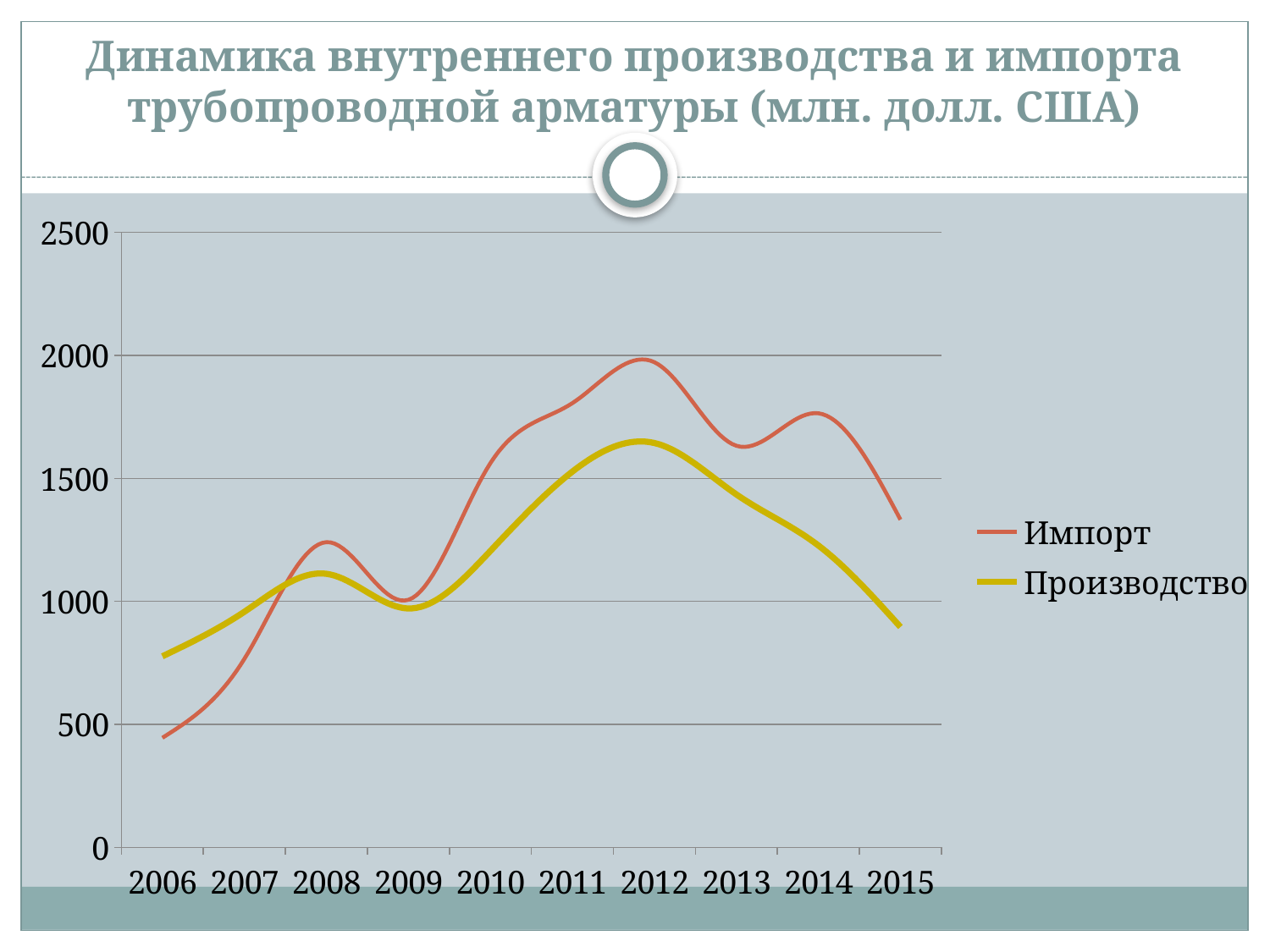
In which year does the Импорт series reach its highest value? 2012 How many years are shown on the x axis? 10 Does the Производство series rise or fall from 2012 to 2015? fall Is the value for Импорт in 2015 greater or less than 1500? less Is the value for Импорт in 2012 greater or less than 1500? greater Is the value for Производство in 2015 greater or less than 1000? less In which year is the Импорт series at its lowest? 2006 What kind of chart is shown on the slide? line chart In 2006, which series has the larger value, Импорт or Производство? Производство In which year is the Производство series at its lowest? 2006 In which year does the Производство series reach its highest value? 2012 How many series does the legend list? 2